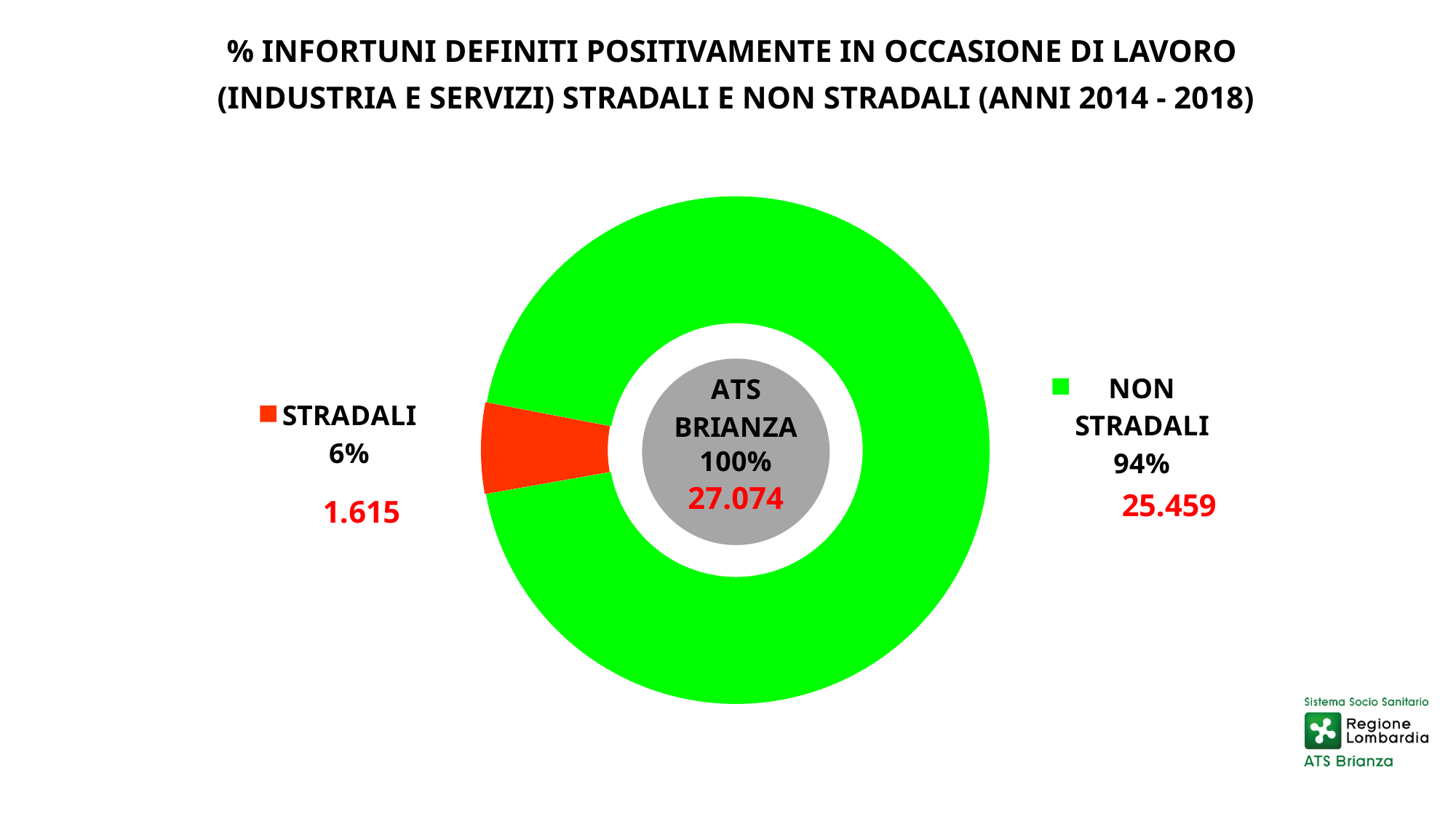
What colour is the STRADALI slice? Red Which category has the largest slice of the chart? NON STRADALI What is the difference between the NON STRADALI and STRADALI values? 23.844 What total number is shown in the centre of the chart for ATS BRIANZA? 27.074 What kind of chart is shown on the slide? Doughnut (pie) chart What percentage of the chart does the NON STRADALI slice represent? 94% What is the number of cases shown for STRADALI? 1.615 How many categories are shown in the chart? 2 Which is larger, the value for STRADALI or the value for NON STRADALI? NON STRADALI Which category has the smallest slice of the chart? STRADALI What percentage of the chart does the STRADALI slice represent? 6% What is the number of cases shown for NON STRADALI? 25.459